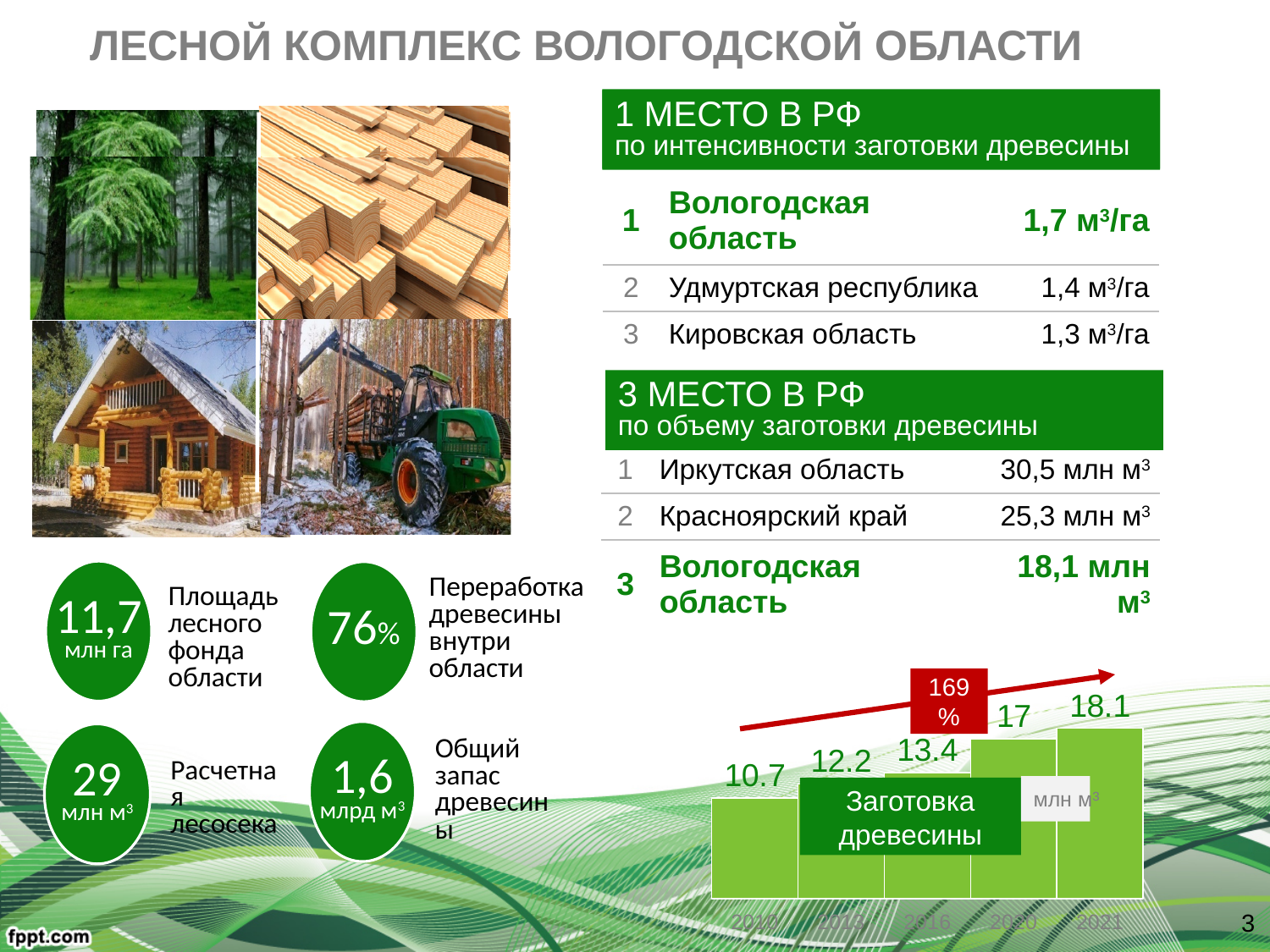
What percentage is shown in the red box above the bar chart at the bottom right? 169% In the bar chart at the bottom right, how many bars are there? 5 In the bar chart at the bottom right, which year has the lowest value? 2010 In the bar chart at the bottom right, which year has the highest value? 2021 In the bar chart at the bottom right, what is the difference between the values for 2021 and 2010? 7.4 In the bar chart at the bottom right, what is the value for 2016? 13.4 In the bar chart at the bottom right, what is the value for 2020? 17 In the bar chart at the bottom right, what is the value for 2010? 10.7 What kind of chart is shown at the bottom right of the slide? bar chart In the bar chart at the bottom right, what is the value for 2021? 18.1 In the bar chart at the bottom right, do the values rise or fall from 2010 to 2021? rise